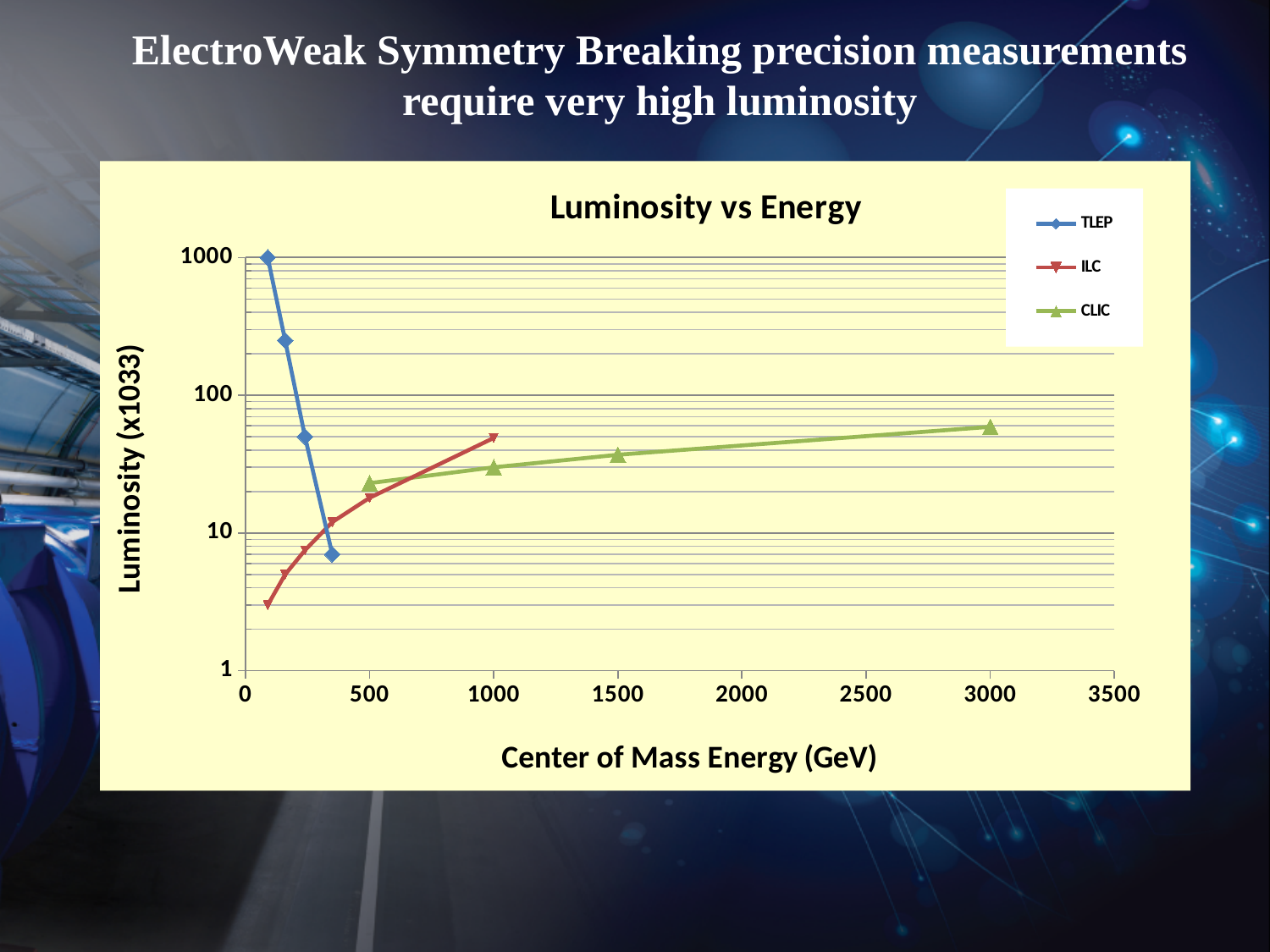
How many series does the legend list? 3 Is the luminosity of the last TLEP point (near 350 GeV) greater or less than 10? less Does the CLIC luminosity rise or fall as the center of mass energy increases? rise Is the luminosity of the ILC point at 1000 GeV greater or less than 100? less What is the label of the x axis? Center of Mass Energy (GeV) Which series reaches the highest luminosity on the chart? TLEP Is the luminosity of the CLIC point at 500 GeV greater or less than 10? greater Which series extends to the highest center of mass energy? CLIC Does the TLEP luminosity rise or fall as the center of mass energy increases? fall How many data points are plotted for the ILC series? 6 What type of chart is shown on the slide? line chart What is the title of the chart? Luminosity vs Energy